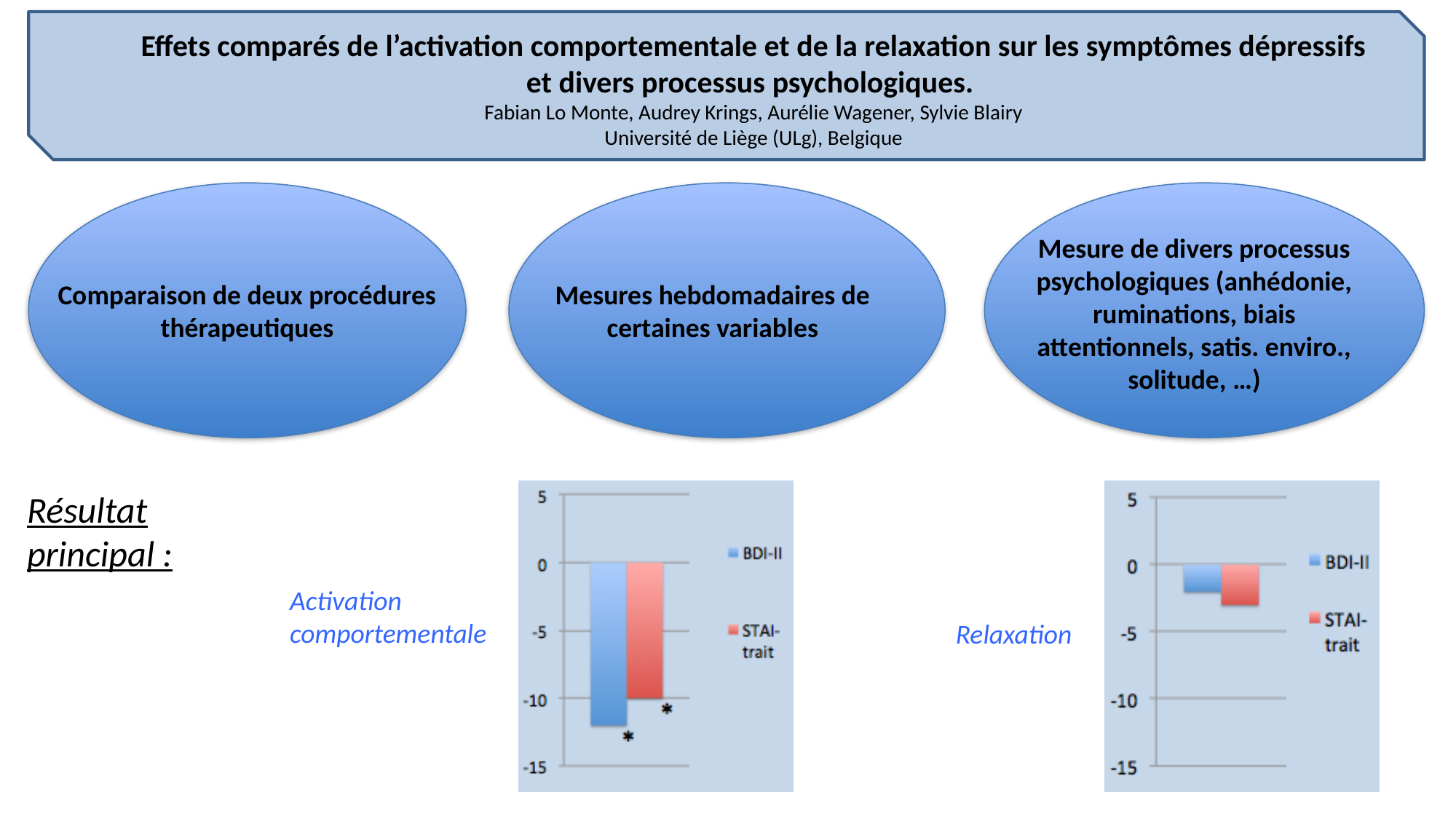
In the Relaxation chart, which series has the lower (more negative) value, BDI-II or STAI-trait? STAI-trait In the Activation comportementale chart, is the value for STAI-trait greater or less than -5? less In the Activation comportementale chart, is the value for BDI-II greater or less than -10? less In the Activation comportementale chart, which series has the lower (more negative) value, BDI-II or STAI-trait? BDI-II Which chart shows the larger decrease in BDI-II, Activation comportementale or Relaxation? Activation comportementale What is the highest value shown on the vertical axis of the Relaxation chart? 5 In the Relaxation chart, is the value for STAI-trait greater or less than -5? greater In the Activation comportementale chart, what colour represents the STAI-trait series? red How many series does the legend of the Relaxation chart list? 2 What kind of chart is the Activation comportementale chart? bar chart